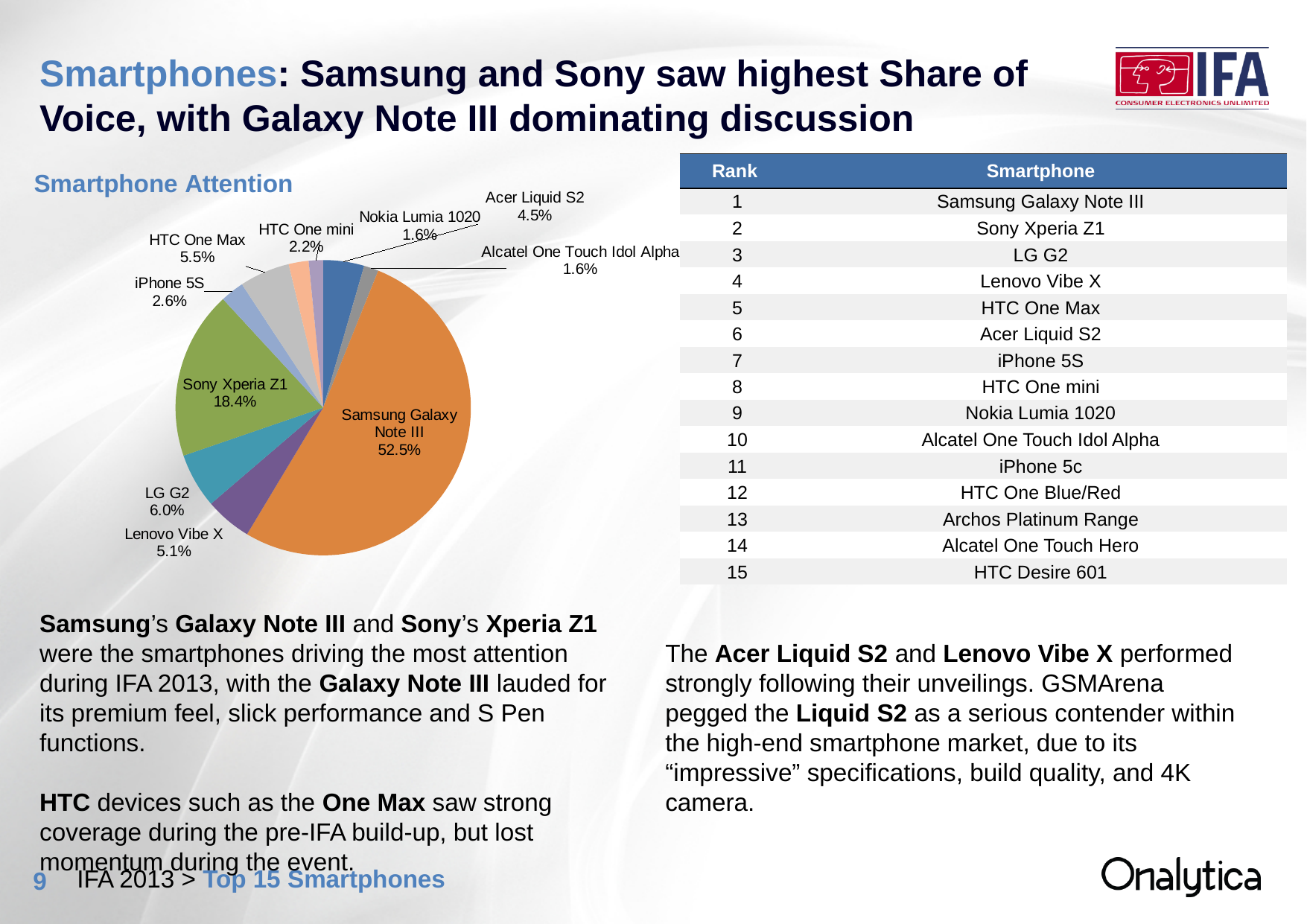
What share of the Smartphone Attention pie does the Samsung Galaxy Note III hold? 52.5% What is the combined share of the Samsung Galaxy Note III and Sony Xperia Z1 slices? 70.9% What kind of chart is shown under the heading "Smartphone Attention"? pie chart Which has the larger share in the pie chart, LG G2 or HTC One Max? LG G2 What percentage is shown for the Acer Liquid S2 in the pie chart? 4.5% Which has the larger share in the pie chart, iPhone 5S or HTC One mini? iPhone 5S What is the value shown for Sony Xperia Z1 in the Smartphone Attention pie chart? 18.4% Which smartphones share the smallest slice value in the pie chart? Nokia Lumia 1020 and Alcatel One Touch Idol Alpha How many slices are labelled in the Smartphone Attention pie chart? 10 What is the difference in percentage points between the Samsung Galaxy Note III and Sony Xperia Z1 slices? 34.1 What value does the pie chart show for Lenovo Vibe X? 5.1% Which smartphone has the largest slice in the Smartphone Attention pie chart? Samsung Galaxy Note III